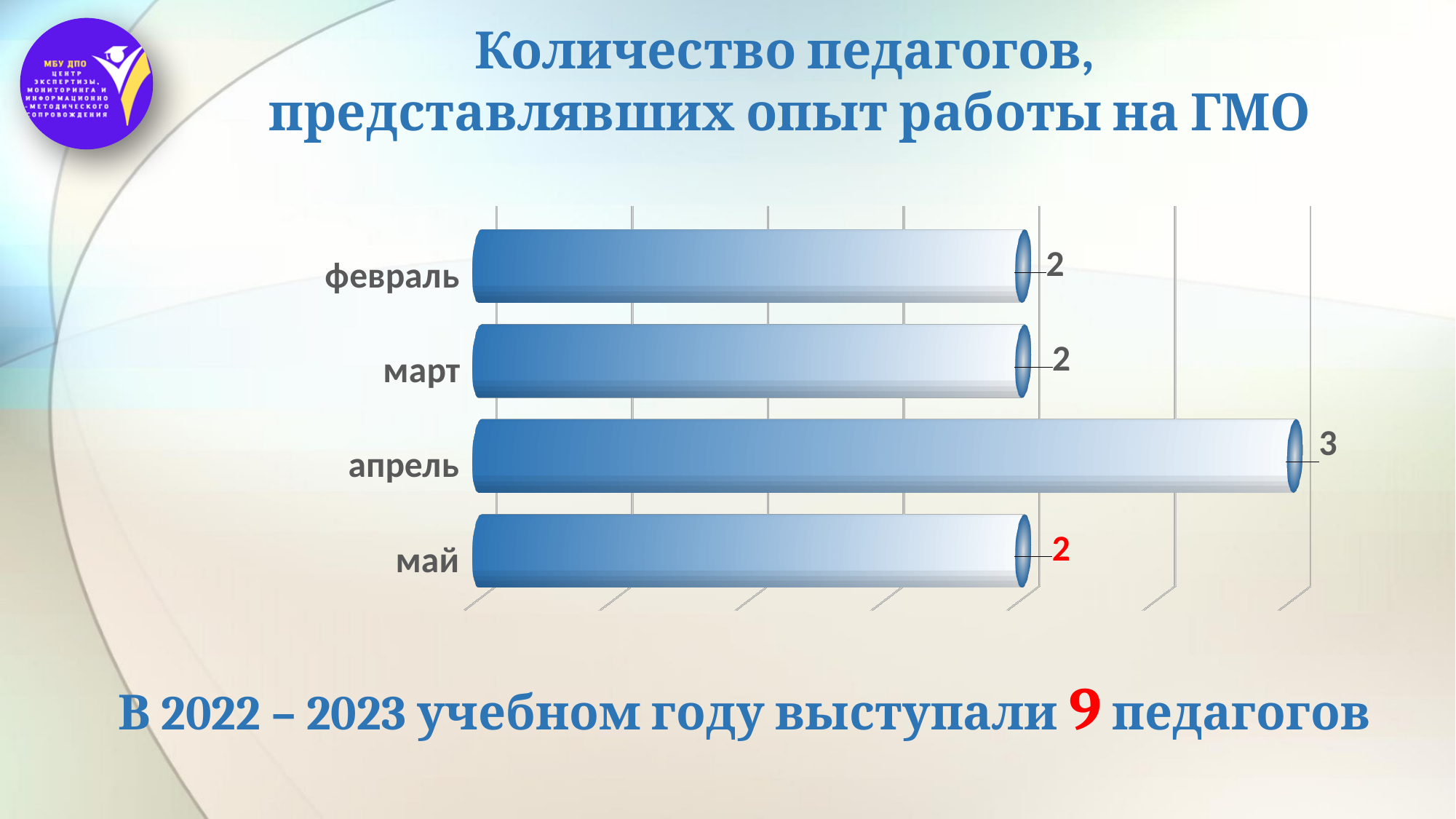
Which month's data label is printed in red? май What kind of chart is shown on the slide? bar chart What is the value for апрель? 3 What is the total of all the values shown on the chart? 9 What is the value for май? 2 Which month has the highest value? апрель How many months are shown on the chart? 4 Which is larger, the value for апрель or the value for февраль? апрель What is the difference between the values for апрель and март? 1 What is the value for март? 2 What is the value for февраль? 2 What is the title of the chart? Количество педагогов, представлявших опыт работы на ГМО